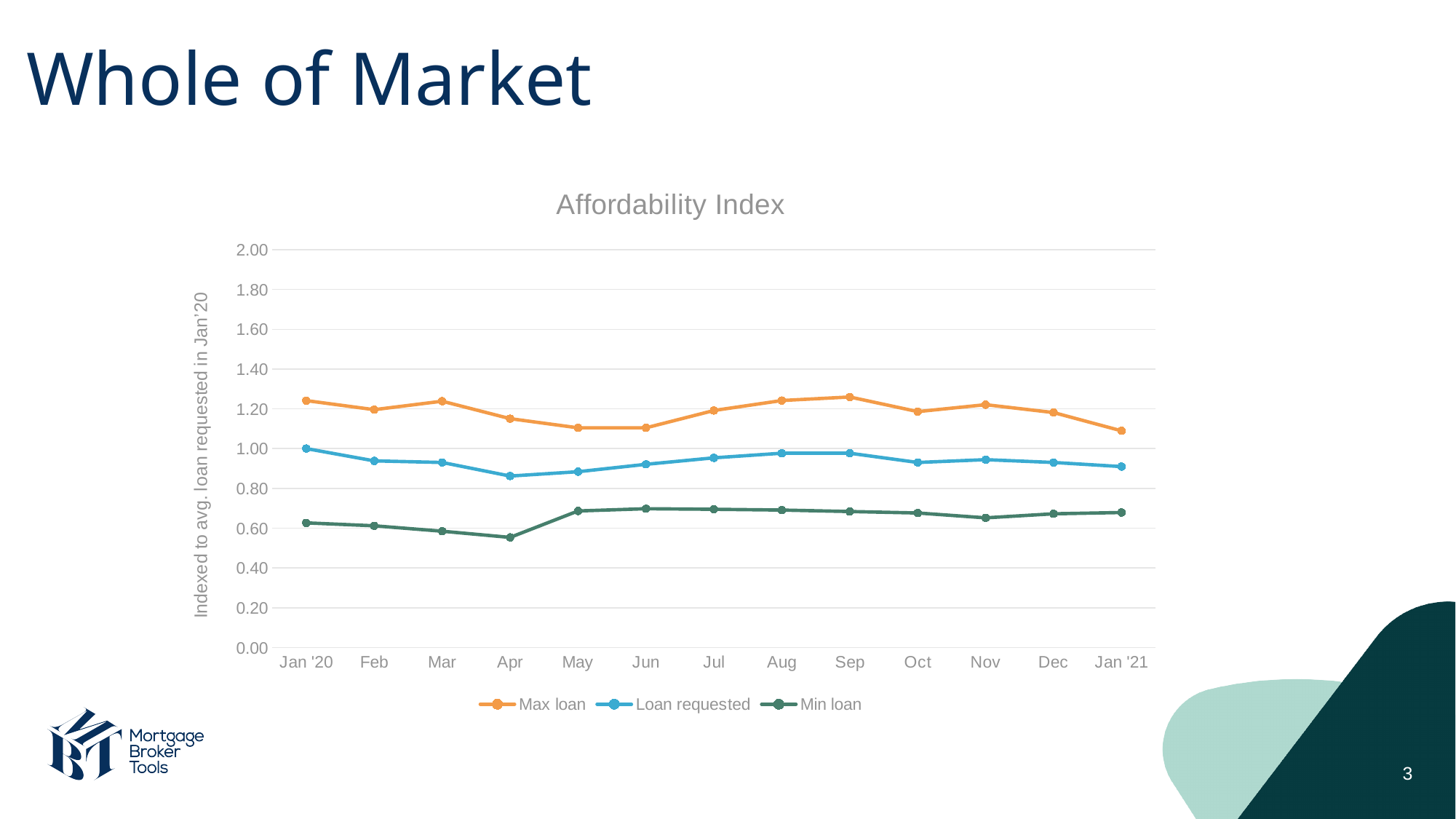
Is the Max loan value in Apr greater or less than 1.20? less How many series does the legend of the Affordability Index chart list? 3 Does the Min loan series rise or fall from Apr to May? rise What is the title of the y axis on the chart? Indexed to avg. loan requested in Jan'20 Is the Loan requested value in Apr greater or less than 1.00? less Which series has the higher value in Sep, Max loan or Min loan? Max loan How many months are plotted along the x axis of the Affordability Index chart? 13 In which month is the Loan requested series at its lowest? Apr What kind of chart is shown on the slide? line chart In which month is the Min loan series at its lowest? Apr What is the value of the Loan requested series in Jan '20? 1.00 Is the Min loan value in Jun greater or less than 0.60? greater